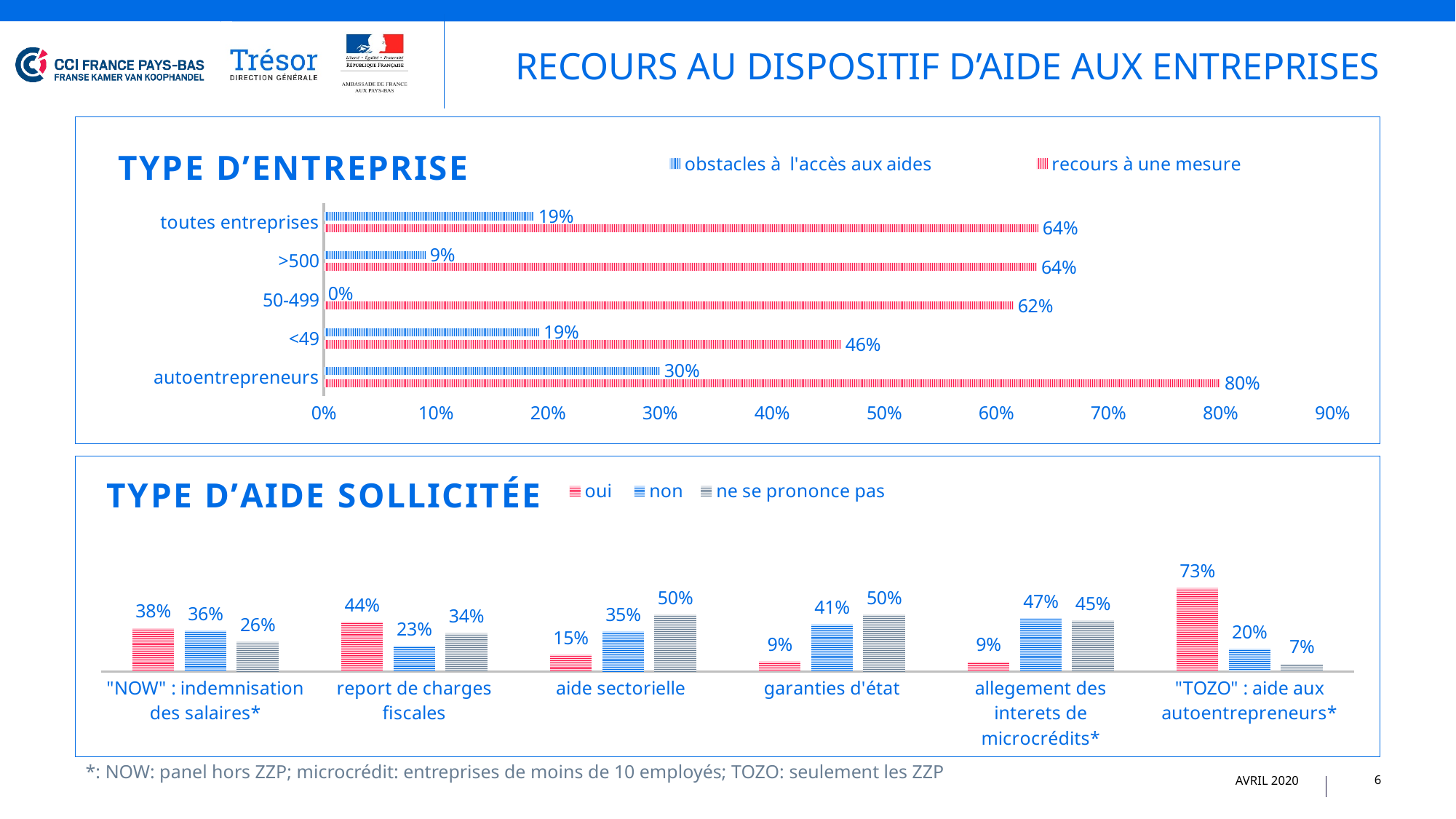
In the "TYPE D'AIDE SOLLICITÉE" chart, what is the difference between the "oui" values for report de charges fiscales and "NOW" : indemnisation des salaires? 6% What kind of chart is the "TYPE D'AIDE SOLLICITÉE" chart? Bar chart In the "TYPE D'ENTREPRISE" chart, how many categories are shown? 5 In the "TYPE D'AIDE SOLLICITÉE" chart, which type of aid has the lowest "oui" value? garanties d'état and allegement des interets de microcrédits (both 9%) In the "TYPE D'ENTREPRISE" chart, which category has the lowest value for "recours à une mesure"? <49 In the "TYPE D'ENTREPRISE" chart, what is the difference between "recours à une mesure" and "obstacles à l'accès aux aides" for autoentrepreneurs? 50% In the "TYPE D'ENTREPRISE" chart, how many series does the legend list? 2 In the "TYPE D'AIDE SOLLICITÉE" chart, how many series does the legend list? 3 In the "TYPE D'AIDE SOLLICITÉE" chart, which is larger for aide sectorielle: "non" or "ne se prononce pas"? ne se prononce pas In the "TYPE D'ENTREPRISE" chart, what is the value of "recours à une mesure" for autoentrepreneurs? 80% In the "TYPE D'ENTREPRISE" chart, what is the value of "obstacles à l'accès aux aides" for >500? 9% In the "TYPE D'AIDE SOLLICITÉE" chart, what is the "oui" value for "TOZO" : aide aux autoentrepreneurs? 73%